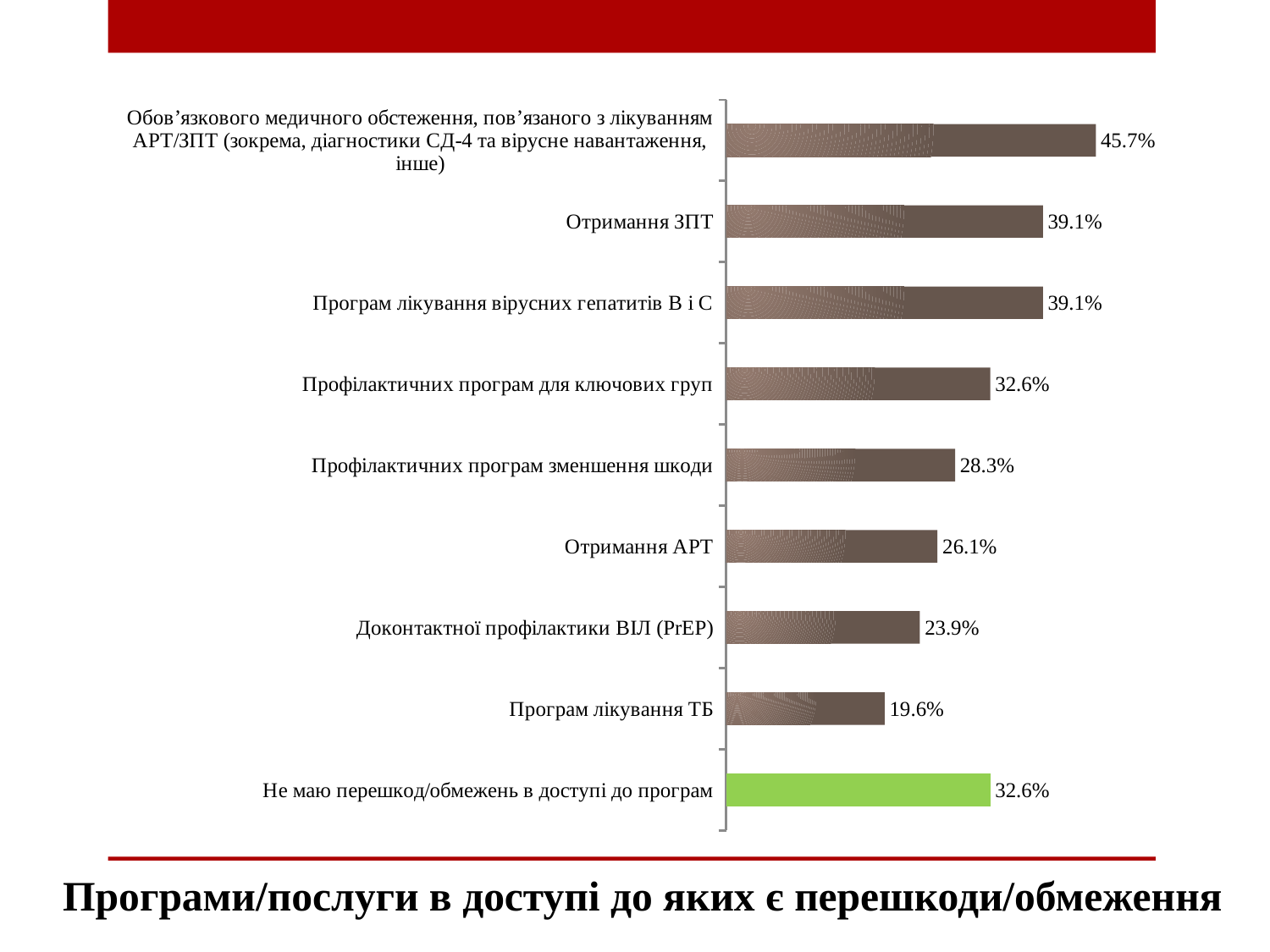
What is the value for "Доконтактної профілактики ВІЛ (PrEP)"? 23.9% Which category has the lowest value? Програм лікування ТБ Which is larger: the value for "Профілактичних програм зменшення шкоди" or the value for "Отримання АРТ"? Профілактичних програм зменшення шкоди Which bar is coloured green rather than brown? Не маю перешкод/обмежень в доступі до програм What is the value for "Отримання ЗПТ"? 39.1% What is the title of the chart? Програми/послуги в доступі до яких є перешкоди/обмеження Which category has the highest value? Обов’язкового медичного обстеження, пов’язаного з лікуванням АРТ/ЗПТ (зокрема, діагностики СД-4 та вірусне навантаження, інше) What is the value for "Не маю перешкод/обмежень в доступі до програм"? 32.6% How many categories are shown in the chart? 9 What kind of chart is shown on the slide? Bar chart What is the value for "Програм лікування ТБ"? 19.6% What is the difference between the values for "Отримання ЗПТ" and "Отримання АРТ"? 13.0%